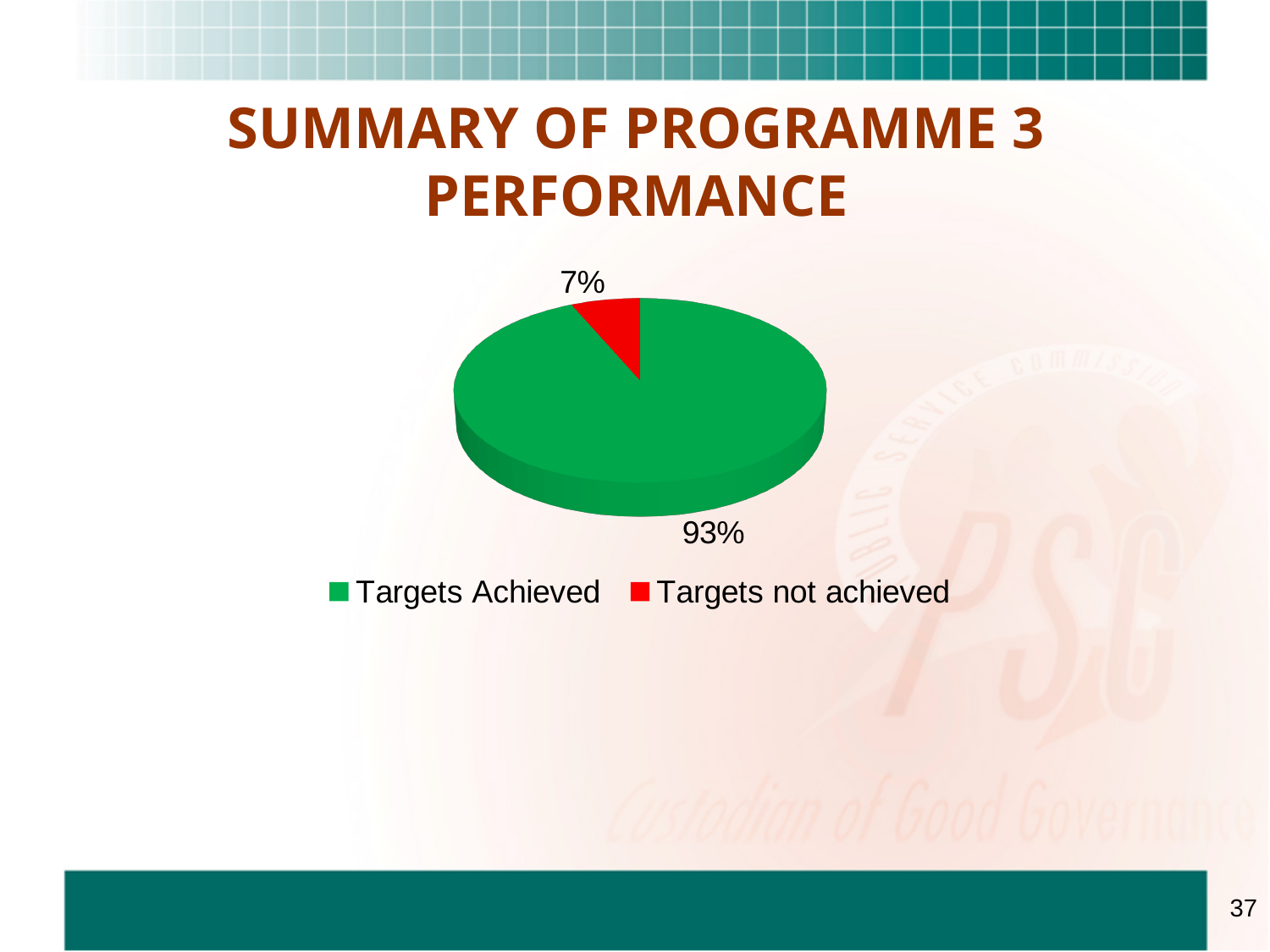
How many slices does the pie chart have? 2 What colour is the Targets Achieved slice? green What share of the pie is labelled Targets not achieved? 7% What is the difference in percentage points between Targets Achieved and Targets not achieved? 86 Which slice of the pie is the largest? Targets Achieved What colour is the Targets not achieved slice? red How many entries does the legend list? 2 What share of the pie is labelled Targets Achieved? 93% What kind of chart is shown on the slide? pie chart Which is larger, the share for Targets Achieved or the share for Targets not achieved? Targets Achieved Which slice of the pie is the smallest? Targets not achieved